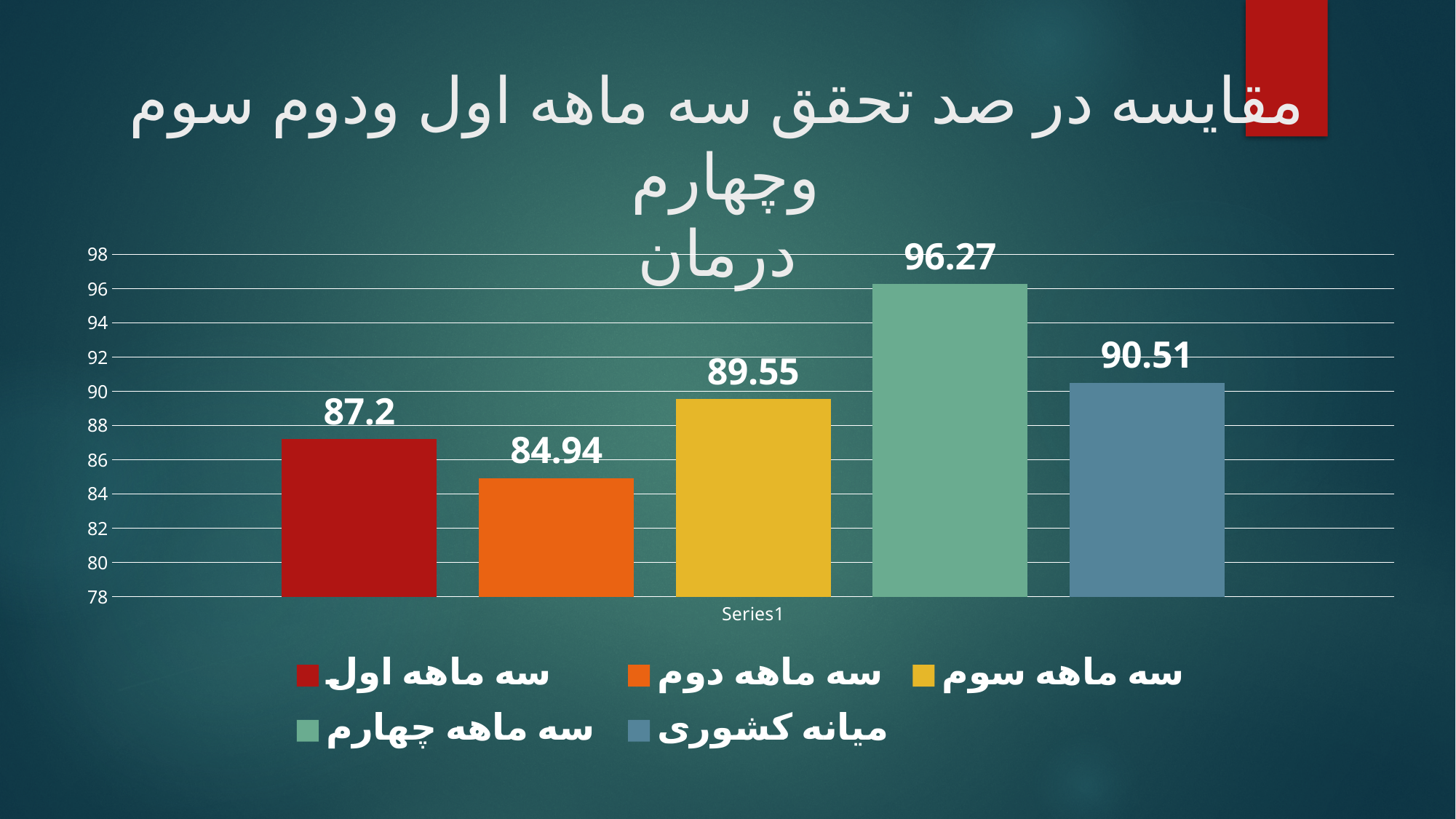
What is the value for سه ماهه چهارم? 96.27 What is the value for سه ماهه دوم? 84.94 How many series does the legend list? 5 What kind of chart is shown on the slide? bar chart What is the difference between the values for سه ماهه چهارم and سه ماهه سوم? 6.72 What is the value for سه ماهه اول? 87.2 Which is larger, the value for سه ماهه سوم or the value for میانه کشوری? میانه کشوری Which series has the lowest value? سه ماهه دوم What is the title of the chart? درمان Is the value for سه ماهه اول greater or less than 90? less Which series has the highest value? سه ماهه چهارم What is the value for میانه کشوری? 90.51